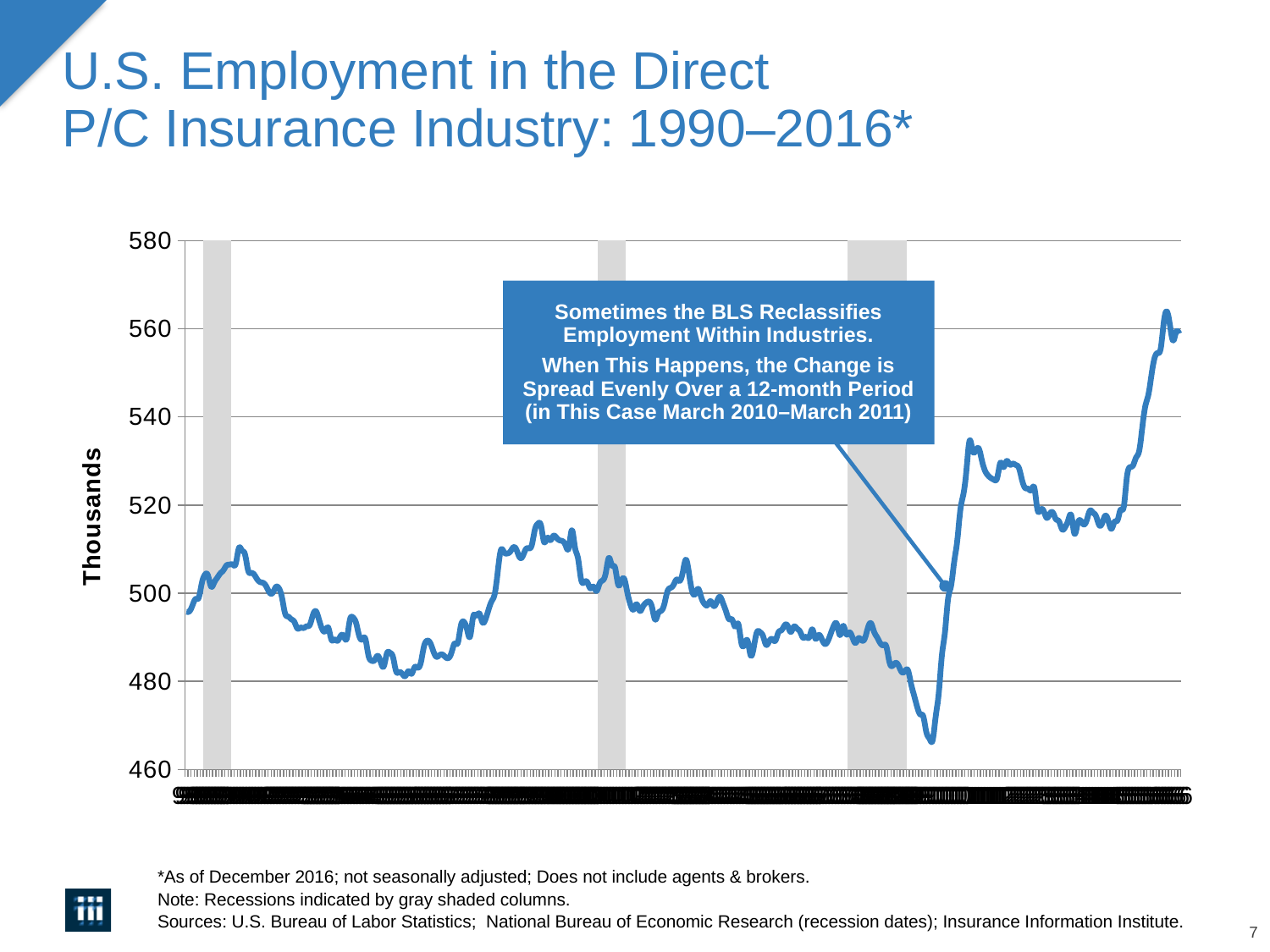
What is the title of the chart on the slide? U.S. Employment in the Direct P/C Insurance Industry: 1990–2016* Is the lowest point of the line greater or less than 480? less Is the value at the end of the series (right end of the line) greater or less than 580? less How many gray shaded recession columns are shown on the chart? 3 What kind of chart is shown on the slide? line chart Is the highest point of the line greater or less than 560? greater Which is larger: the value at the right end of the line or the value at the left end of the line? the right end Overall, does the line rise or fall from the left end of the x axis to the right end? rise What is the label on the vertical axis of the chart? Thousands What is the lowest value shown on the vertical axis of the chart? 460